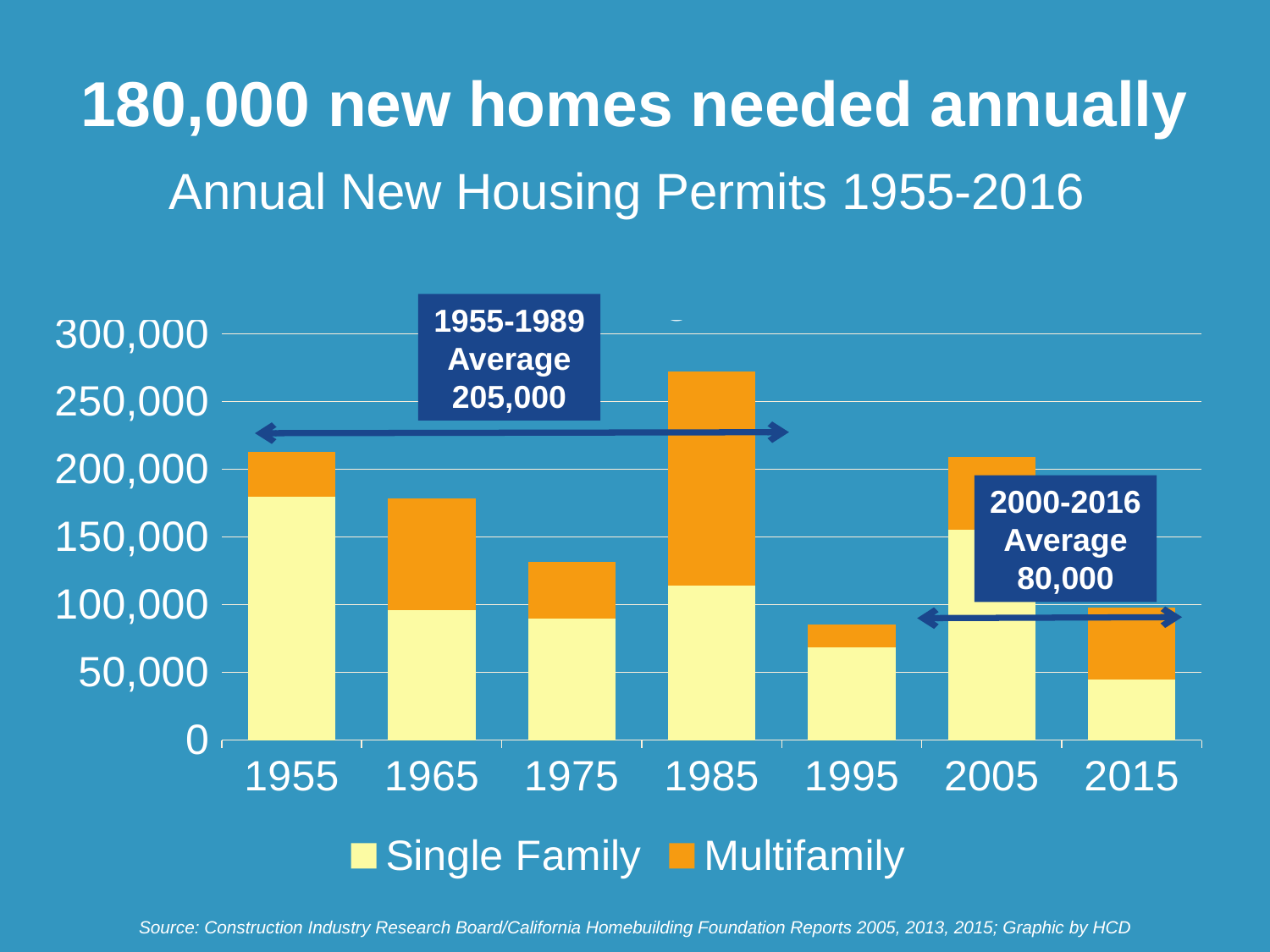
According to the annotation on the chart, what was the average annual number of permits for 1955-1989? 205,000 How many years are shown on the x axis? 7 Which year has the larger total number of permits, 1955 or 1975? 1955 Is the total value for 1985 greater or less than 250,000? greater What kind of chart is shown on the slide? stacked bar chart Is the Single Family value for 2015 greater or less than 50,000? less Is the total value for 1995 greater or less than 100,000? less Which year has the larger Single Family value, 1955 or 2005? 1955 Which year has the lowest total number of housing permits? 1995 According to the annotation on the chart, what was the average annual number of permits for 2000-2016? 80,000 How many series does the legend list? 2 Which year has the highest total number of housing permits? 1985